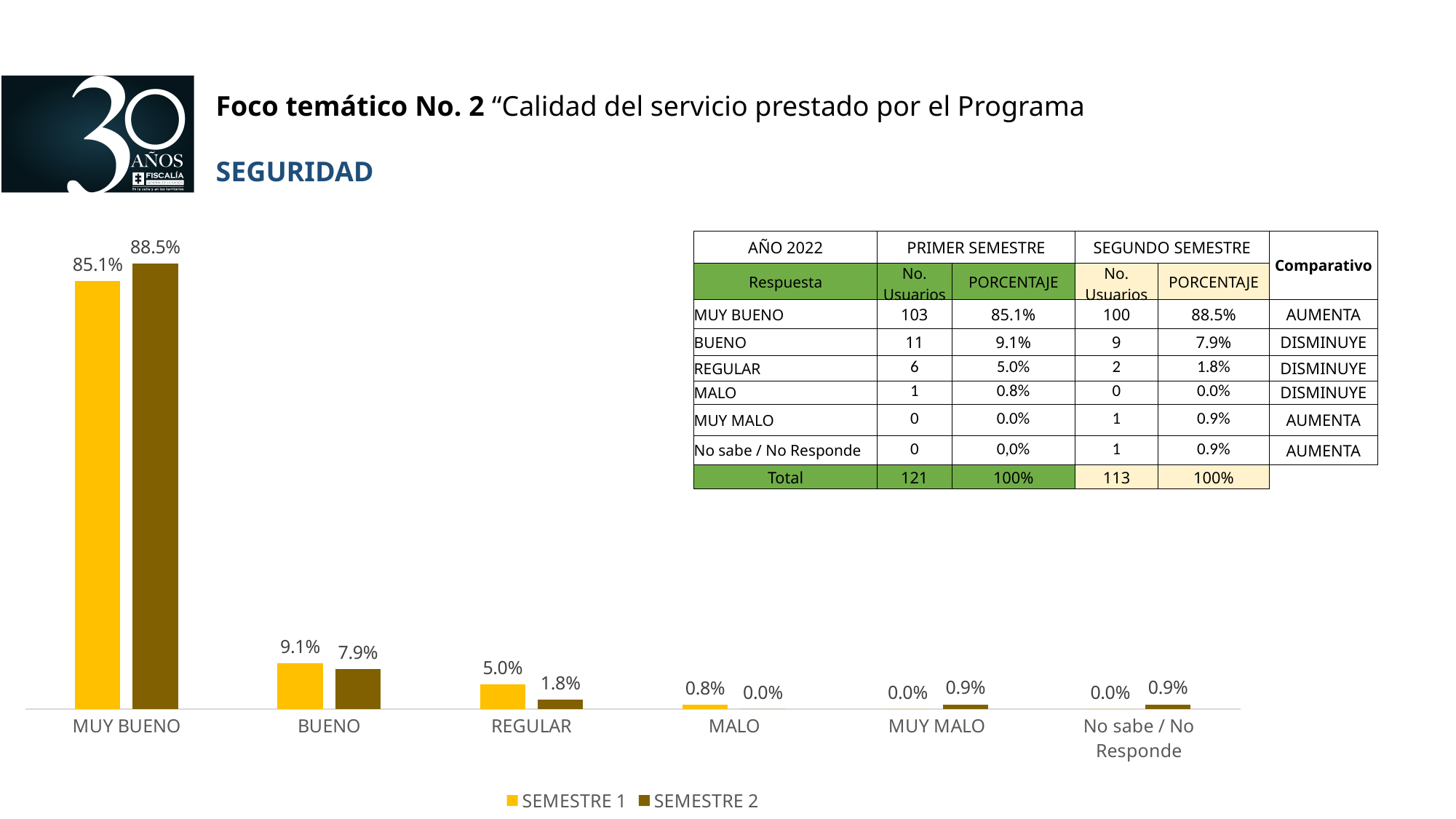
How many series does the chart legend list? 2 What is the difference between the SEMESTRE 2 and SEMESTRE 1 values for MUY BUENO? 3.4% How many categories are shown on the x axis of the chart? 6 Which series is shown in the darker brown colour in the chart? SEMESTRE 2 What is the value for MUY BUENO in the SEMESTRE 1 series? 85.1% Which is larger for BUENO: the SEMESTRE 1 value or the SEMESTRE 2 value? SEMESTRE 1 What kind of chart is shown on the slide? Bar chart What is the value for REGULAR in the SEMESTRE 2 series? 1.8% What is the value for MUY BUENO in the SEMESTRE 2 series? 88.5% Which category has the highest value in the SEMESTRE 2 series? MUY BUENO What is the value for BUENO in the SEMESTRE 1 series? 9.1% What is the difference between the SEMESTRE 1 and SEMESTRE 2 values for REGULAR? 3.2%